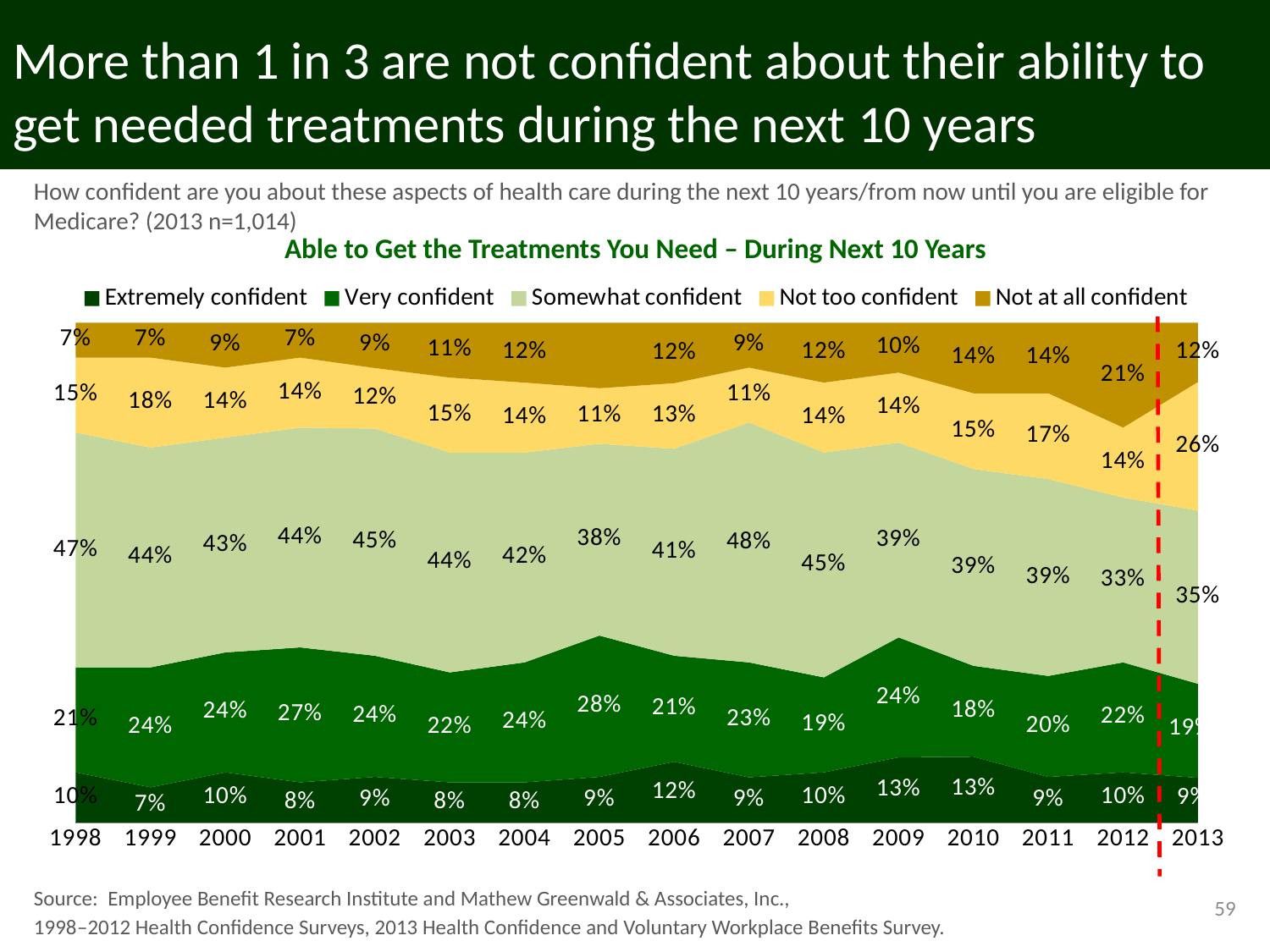
Which year had a larger Very confident share, 2005 or 2008? 2005 How many series does the legend list? 5 In which year was the Somewhat confident share lowest? 2012 In which year was the Not at all confident share highest? 2012 How many years are shown on the x axis? 16 What kind of chart is shown on the slide? Stacked area chart In which year was the Somewhat confident share highest? 2007 What is the value for Extremely confident in 2009? 13% What is the value for Not too confident in 2013? 26% What percentage of respondents were somewhat confident in 2013? 35% By how many percentage points did Not too confident increase from 2012 to 2013? 12 percentage points What percentage were not at all confident in 2012? 21%